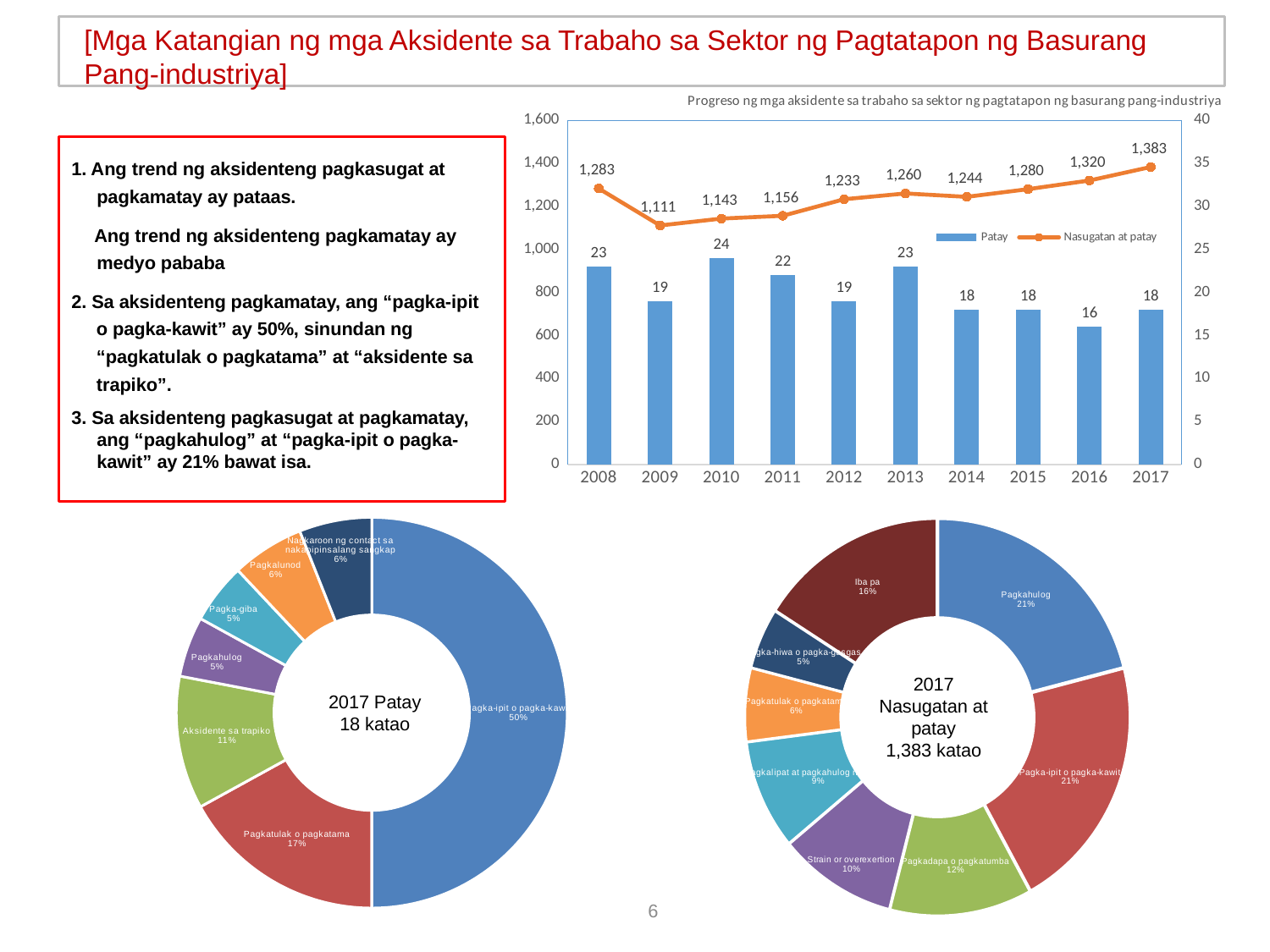
In the top-right chart 'Progreso ng mga aksidente sa trabaho sa sektor ng pagtatapon ng basurang pang-industriya', how many series does the legend list? 2 In the bottom-left donut chart '2017 Patay 18 katao', what share does 'Pagka-ipit o pagka-kawit' have? 50% In the top-right chart 'Progreso ng mga aksidente sa trabaho sa sektor ng pagtatapon ng basurang pang-industriya', which year has the lowest 'Patay' value? 2016 In the top-right chart 'Progreso ng mga aksidente sa trabaho sa sektor ng pagtatapon ng basurang pang-industriya', what is the value of 'Patay' for 2010? 24 In the top-right chart 'Progreso ng mga aksidente sa trabaho sa sektor ng pagtatapon ng basurang pang-industriya', does the 'Nasugatan at patay' line generally rise or fall from 2009 to 2017? rise In the top-right chart 'Progreso ng mga aksidente sa trabaho sa sektor ng pagtatapon ng basurang pang-industriya', how many years are shown on the x axis? 10 In the bottom-right donut chart '2017 Nasugatan at patay 1,383 katao', which is larger, 'Strain or overexertion' or 'Iba pa'? Iba pa In the bottom-left donut chart '2017 Patay 18 katao', what share does 'Aksidente sa trapiko' have? 11% In the bottom-right donut chart '2017 Nasugatan at patay 1,383 katao', what share does 'Pagkadapa o pagkatumba' have? 12% In the top-right chart 'Progreso ng mga aksidente sa trabaho sa sektor ng pagtatapon ng basurang pang-industriya', which year has the lowest 'Nasugatan at patay' value? 2009 In the top-right chart 'Progreso ng mga aksidente sa trabaho sa sektor ng pagtatapon ng basurang pang-industriya', what is the difference between the 'Nasugatan at patay' values for 2017 and 2008? 100 In the top-right chart 'Progreso ng mga aksidente sa trabaho sa sektor ng pagtatapon ng basurang pang-industriya', what is the value of 'Nasugatan at patay' for 2017? 1,383